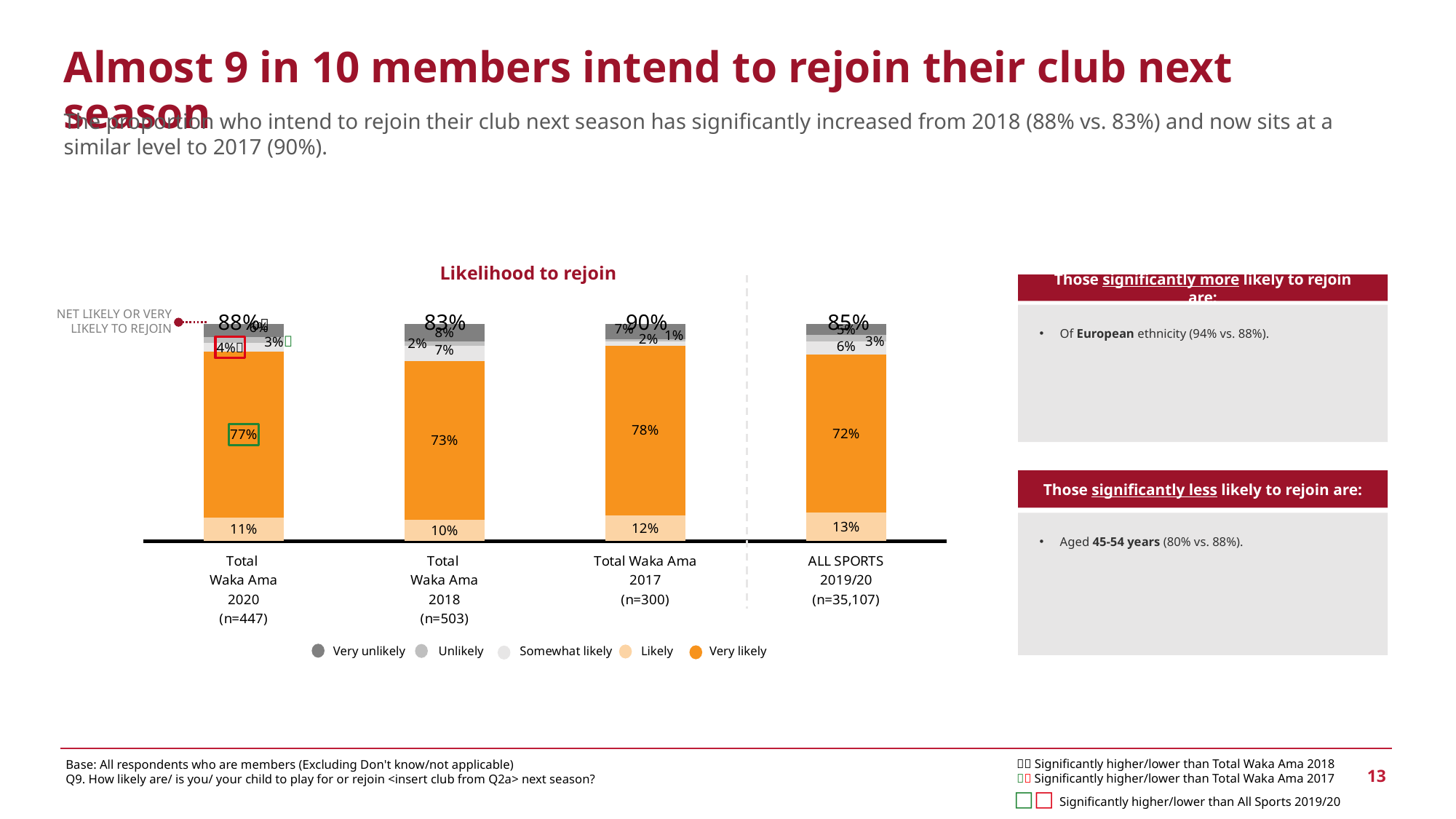
Which group has the lowest 'Very likely' percentage? ALL SPORTS 2019/20 Which group has the highest 'Very likely' percentage? Total Waka Ama 2017 Which is larger: the 'Likely' percentage for Total Waka Ama 2017 or for Total Waka Ama 2018? Total Waka Ama 2017 What is the 'Somewhat likely' percentage for Total Waka Ama 2018? 7% How many series does the chart legend list? 5 What is the net likely or very likely to rejoin figure for Total Waka Ama 2018? 83% What is the 'Likely' percentage for ALL SPORTS 2019/20? 13% What is the 'Very likely' percentage for Total Waka Ama 2020? 77% How many bars (groups) are plotted in the chart? 4 What is the title of the chart? Likelihood to rejoin What is the difference between the net likely to rejoin figures for Total Waka Ama 2020 and Total Waka Ama 2018? 5 percentage points What type of chart is shown on the slide? Stacked bar chart